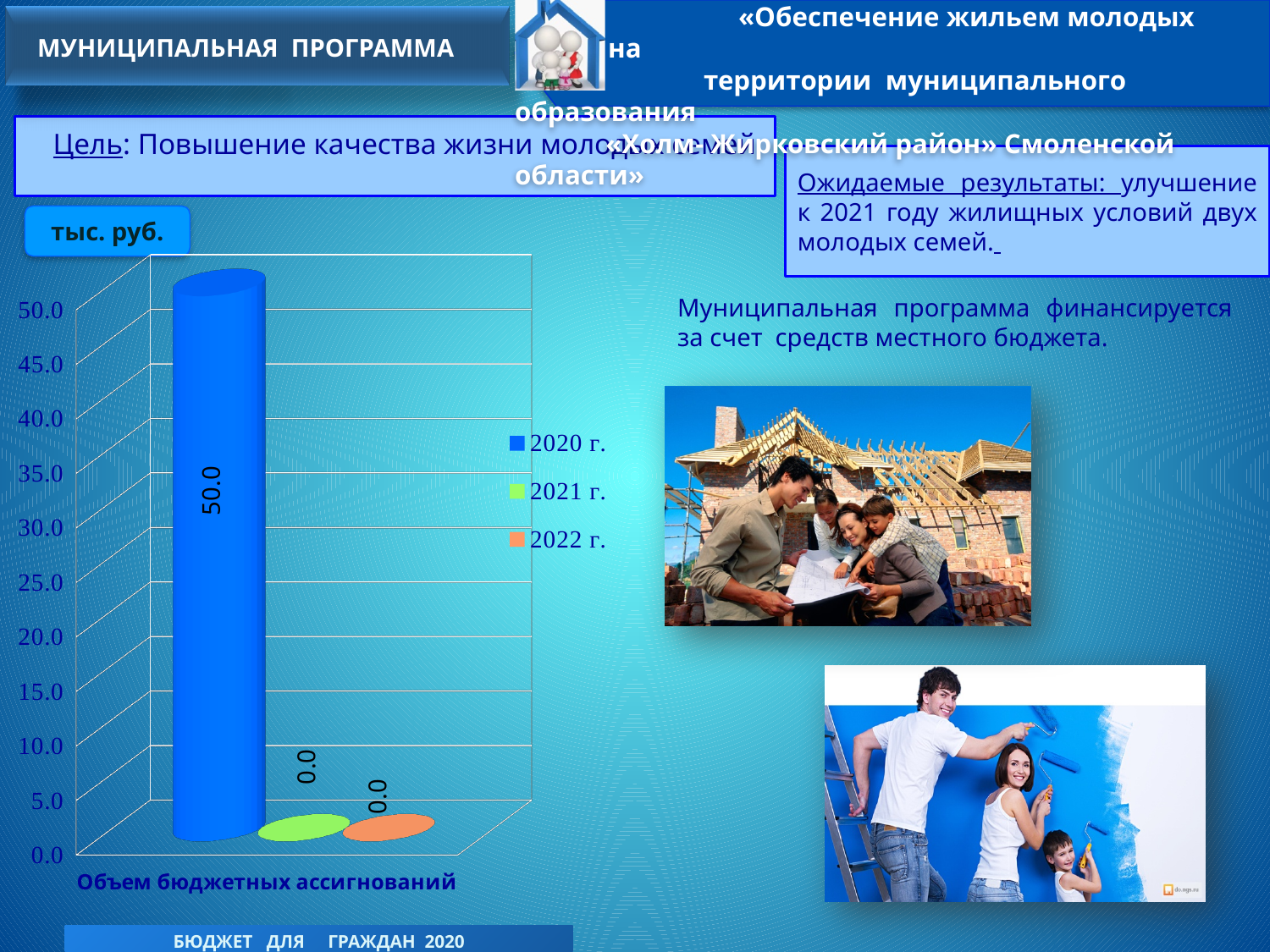
What is the difference between the values for 2020 г. and 2021 г.? 50.0 What kind of chart is shown on the slide? bar chart What is the value for 2021 г. in the chart? 0.0 What unit is indicated for the chart values? тыс. руб. Is the value for 2020 г. greater or less than 45.0? greater What is the category label shown below the chart? Объем бюджетных ассигнований What is the value for 2022 г. in the chart? 0.0 Which is larger, the value for 2020 г. or the value for 2022 г.? 2020 г. How many series does the legend list? 3 What is the total of the values for 2020 г., 2021 г. and 2022 г.? 50.0 What is the value for 2020 г. in the chart? 50.0 Which year has the highest value in the chart? 2020 г.